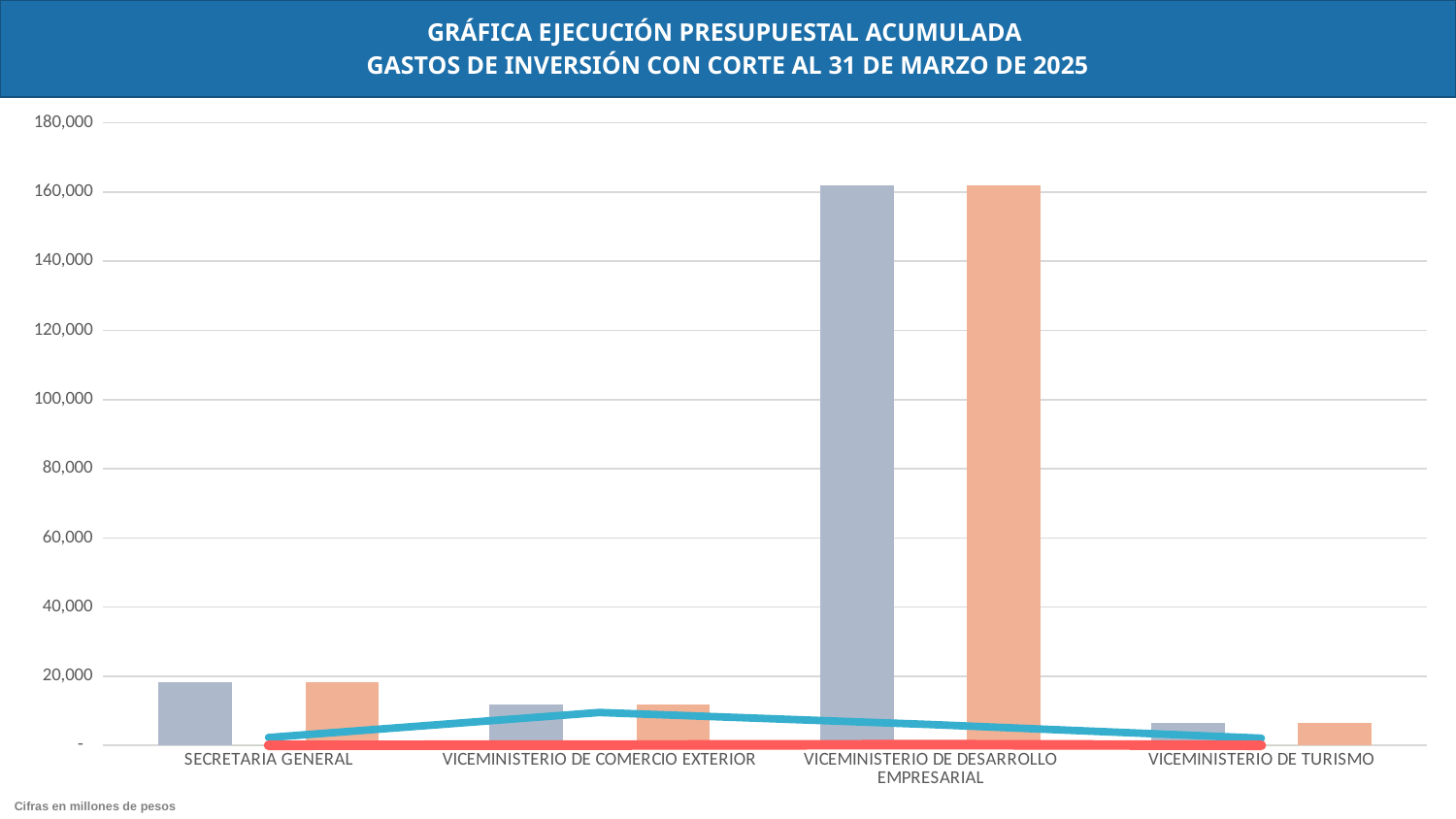
Which category has the shortest bars in the chart? VICEMINISTERIO DE TURISMO Is the value of the gray bar for SECRETARIA GENERAL greater or less than 20,000? less Which category has the tallest bars in the chart? VICEMINISTERIO DE DESARROLLO EMPRESARIAL What is the highest value shown on the vertical axis of the chart? 180,000 Which has the taller gray bar, SECRETARIA GENERAL or VICEMINISTERIO DE COMERCIO EXTERIOR? SECRETARIA GENERAL Which has the taller orange bar, VICEMINISTERIO DE DESARROLLO EMPRESARIAL or VICEMINISTERIO DE TURISMO? VICEMINISTERIO DE DESARROLLO EMPRESARIAL What kind of chart is shown on the slide? combination bar and line chart How many categories are shown on the x axis of the chart? 4 According to the note below the chart, in what units are the figures expressed? millones de pesos Is the value of the gray bar for VICEMINISTERIO DE DESARROLLO EMPRESARIAL greater or less than 140,000? greater Is the value of the orange bar for VICEMINISTERIO DE TURISMO greater or less than 20,000? less